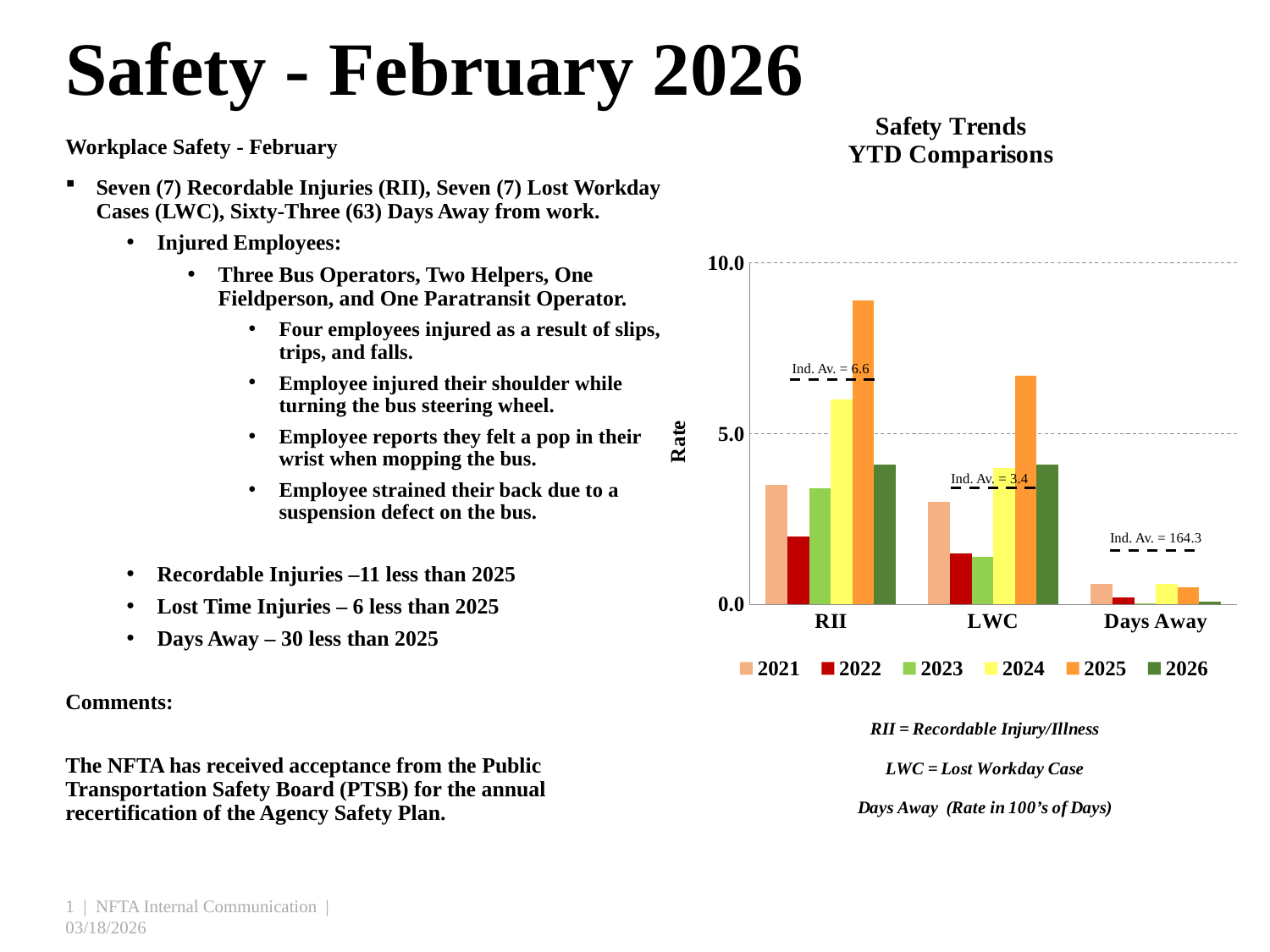
In the Safety Trends chart, is the 2021 value for LWC greater or less than 5.0? less In the Safety Trends chart, is the 2025 value for LWC greater or less than 5.0? greater What type of chart is shown under the title 'Safety Trends YTD Comparisons'? bar chart How many categories are shown on the x axis of the Safety Trends chart? 3 In the Safety Trends chart, which year has the lowest bar in the RII category? 2022 In the Safety Trends chart, is the 2025 value for RII greater or less than 5.0? greater What industry average (Ind. Av.) is marked for the RII category in the Safety Trends chart? 6.6 What industry average (Ind. Av.) is marked for the Days Away category in the Safety Trends chart? 164.3 In the Safety Trends chart, which year has the highest bar in the LWC category? 2025 In the Safety Trends chart, which is larger for RII: the 2022 bar or the 2023 bar? 2023 How many series does the legend of the Safety Trends chart list? 6 In the Safety Trends chart, which year has the highest bar in the RII category? 2025